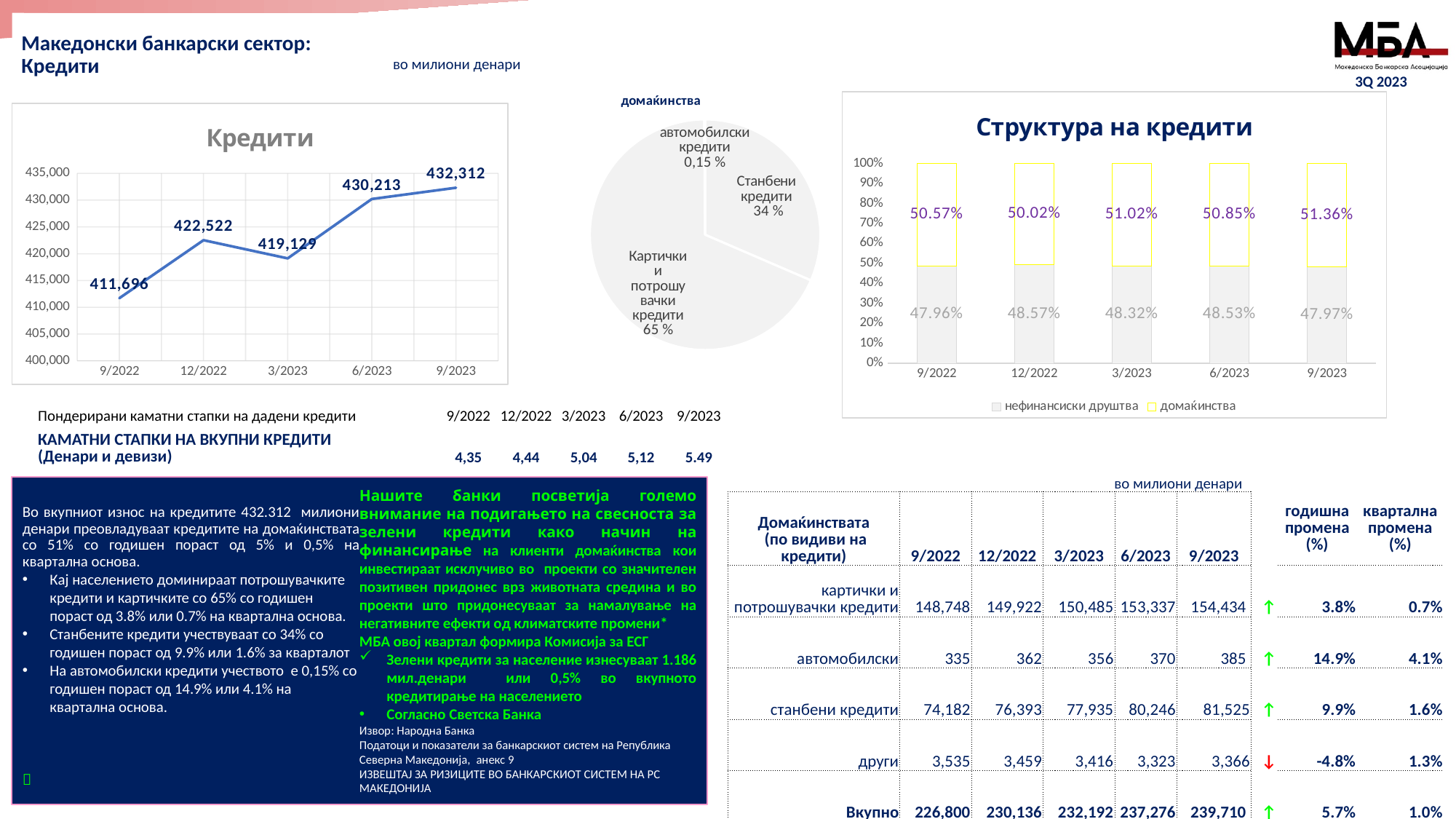
In the 'Структура на кредити' chart, which is larger in 3/2023: 'домаќинства' or 'нефинансиски друштва'? домаќинства In the 'Кредити' line chart, what is the value for 9/2023? 432,312 In the 'Кредити' line chart, which period has the lowest value? 9/2022 In the 'Структура на кредити' chart, what is the value for 'домаќинства' in 9/2023? 51.36% What kind of chart is the 'Кредити' chart? line chart In the 'Кредити' line chart, which period has the highest value? 9/2023 In the 'домаќинства' pie chart, what share do 'Станбени кредити' have? 34 % In the 'Кредити' line chart, what is the difference between the values for 9/2023 and 9/2022? 20,616 How many data points are plotted in the 'Кредити' line chart? 5 How many series does the legend of the 'Структура на кредити' chart list? 2 In the 'домаќинства' pie chart, which slice is the largest? Картички и потрошувачки кредити In the 'Кредити' line chart, does the value rise or fall from 12/2022 to 3/2023? fall